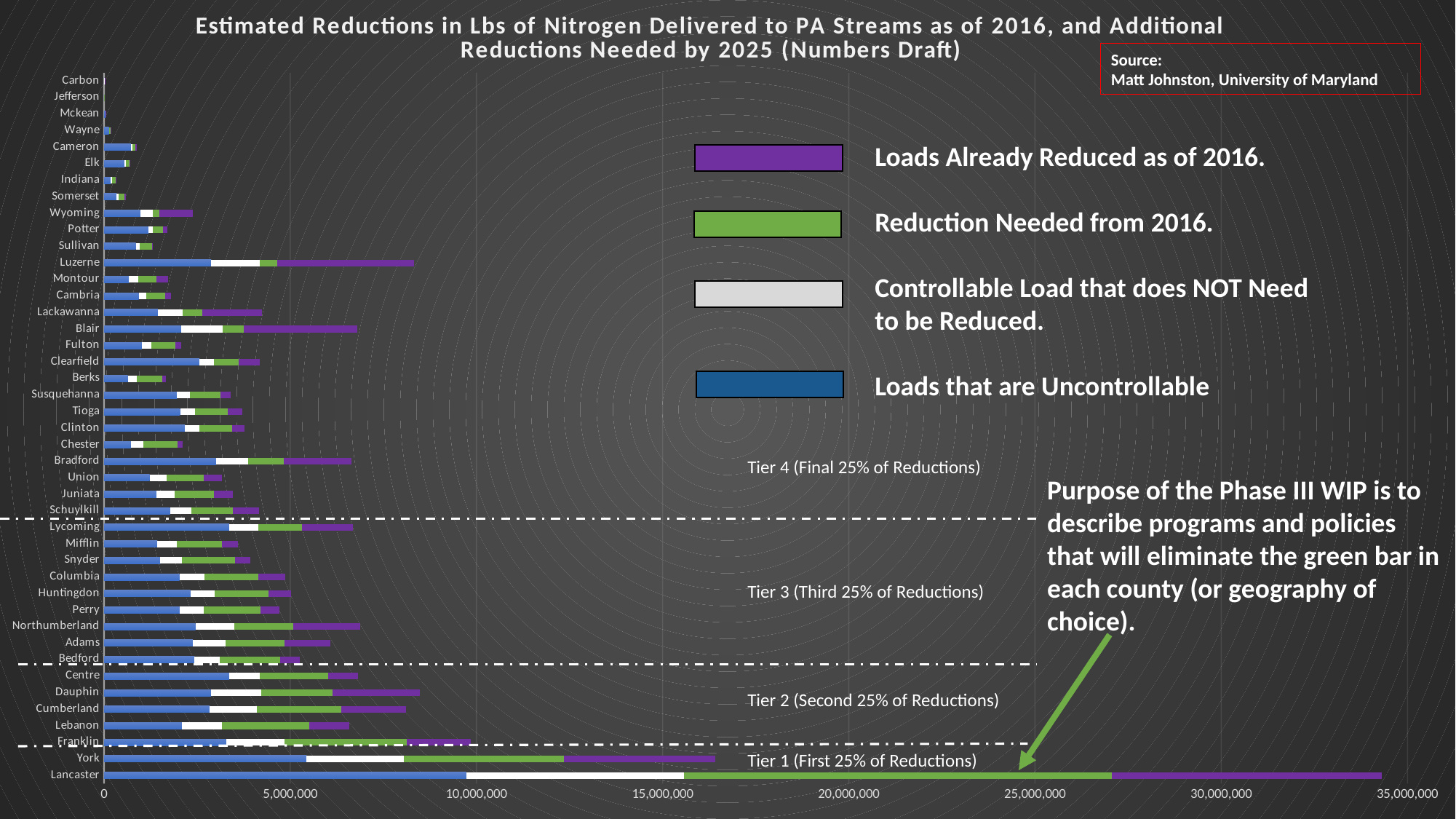
Which county has the larger total bar, Lancaster or York? Lancaster What kind of chart is shown on the slide? Bar chart How many counties are plotted on the chart? 43 What does the purple colour represent according to the legend? Loads Already Reduced as of 2016. Which colour represents 'Reduction Needed from 2016' in the legend? Green Is the total bar for Lancaster greater or less than 30,000,000? greater Is the total bar for Centre greater or less than 10,000,000? less Is the total bar for York greater or less than 15,000,000? greater How many series does the legend list? 4 Which county has the larger total bar, Dauphin or Centre? Dauphin Which county has the longest total bar? Lancaster